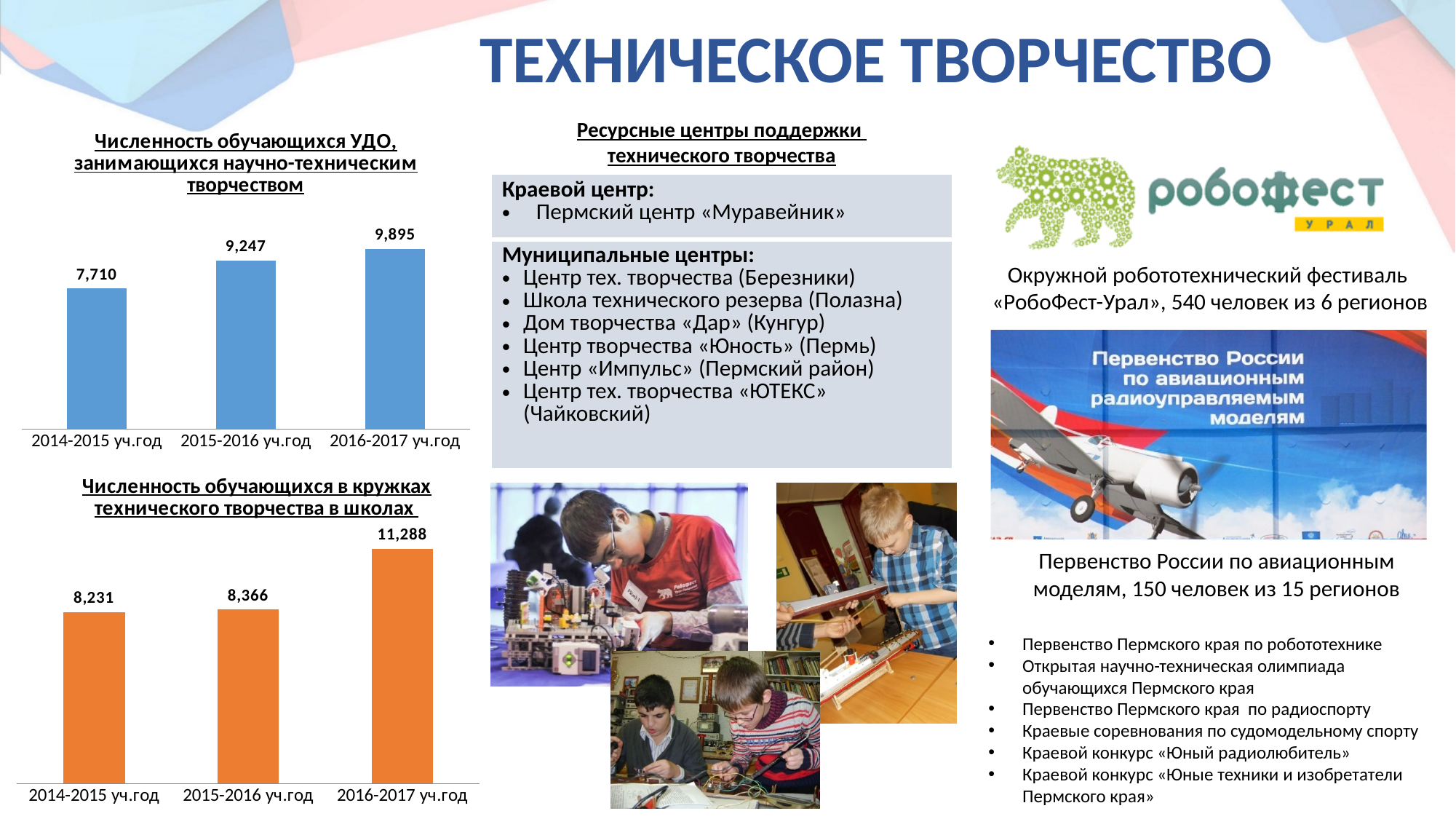
In the top-left chart (Численность обучающихся УДО), do the values rise or fall from 2014-2015 to 2016-2017? rise In the top-left chart (Численность обучающихся УДО, занимающихся научно-техническим творчеством), what is the value for 2014-2015 уч.год? 7,710 In the top-left chart (Численность обучающихся УДО), what is the value for 2016-2017 уч.год? 9,895 In the bottom-left chart (кружки технического творчества в школах), what is the difference between the 2016-2017 and 2014-2015 values? 3,057 In the top-left chart (Численность обучающихся УДО), what is the difference between the 2016-2017 and 2015-2016 values? 648 In the bottom-left chart (Численность обучающихся в кружках технического творчества в школах), what is the value for 2015-2016 уч.год? 8,366 In the top-left chart (Численность обучающихся УДО), which year has the lowest value? 2014-2015 уч.год Which is larger: the 2016-2017 value in the top-left chart (УДО) or the 2016-2017 value in the bottom-left chart (школы)? bottom-left chart (школы), 11,288 In the bottom-left chart (кружки технического творчества в школах), how many years are shown? 3 In the bottom-left chart (Численность обучающихся в кружках технического творчества в школах), which year has the highest value? 2016-2017 уч.год What colour are the bars in the bottom-left chart (кружки технического творчества в школах)? orange What type of chart is the bottom-left chart (кружки технического творчества в школах)? bar chart